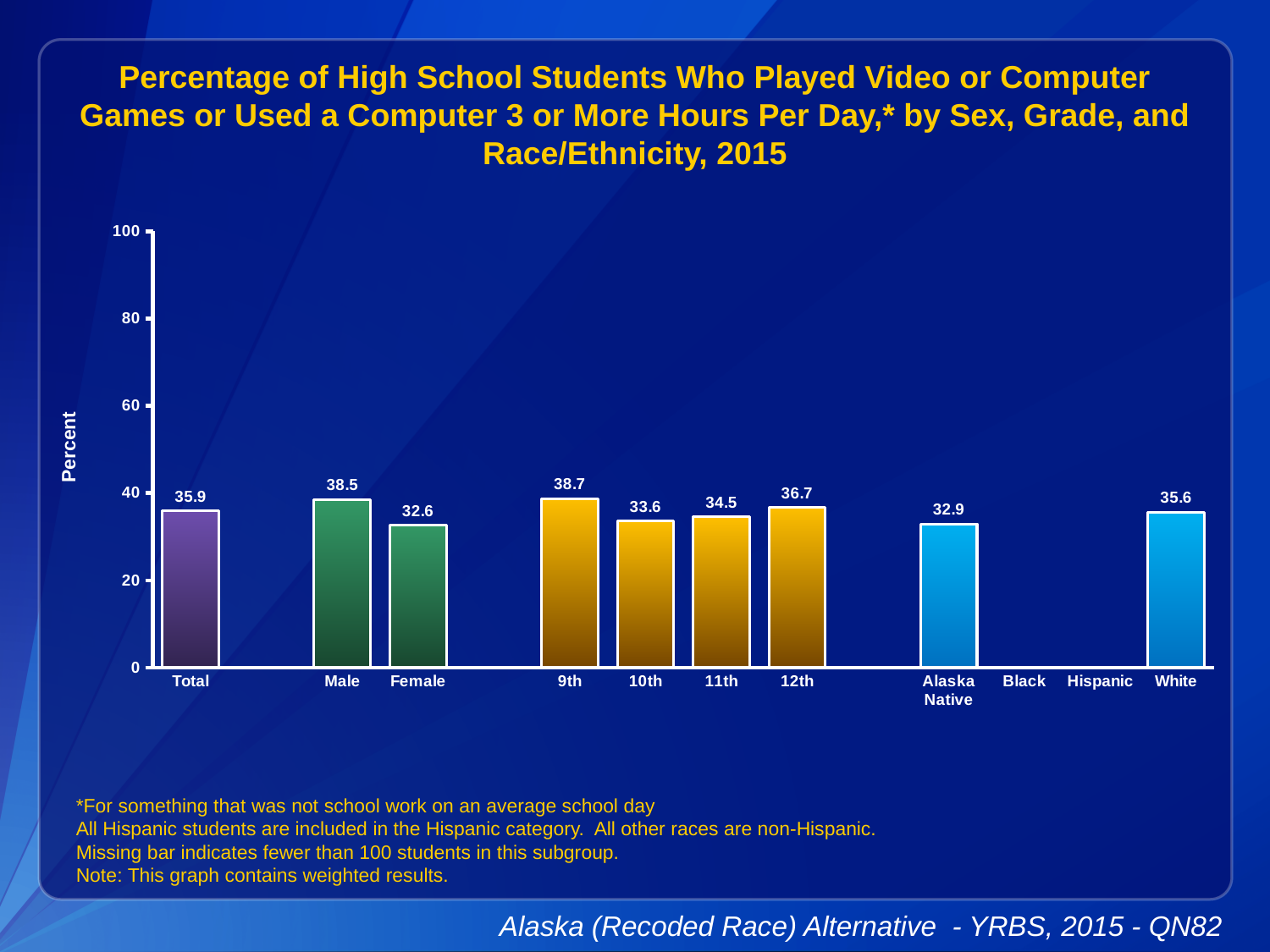
What is the difference between the Male and Female values? 5.9 Which category has the lowest value among those with a bar? Female What is the value for Alaska Native? 32.9 How many categories on the x axis have a bar plotted? 9 What is the value for 12th grade? 36.7 Which category has the highest value? 9th What kind of chart is shown? bar chart Is the value for White greater or less than 40? less Which is larger, the value for 10th grade or 11th grade? 11th What is the label on the y axis? Percent What is the value for Female? 32.6 What is the value for Total? 35.9